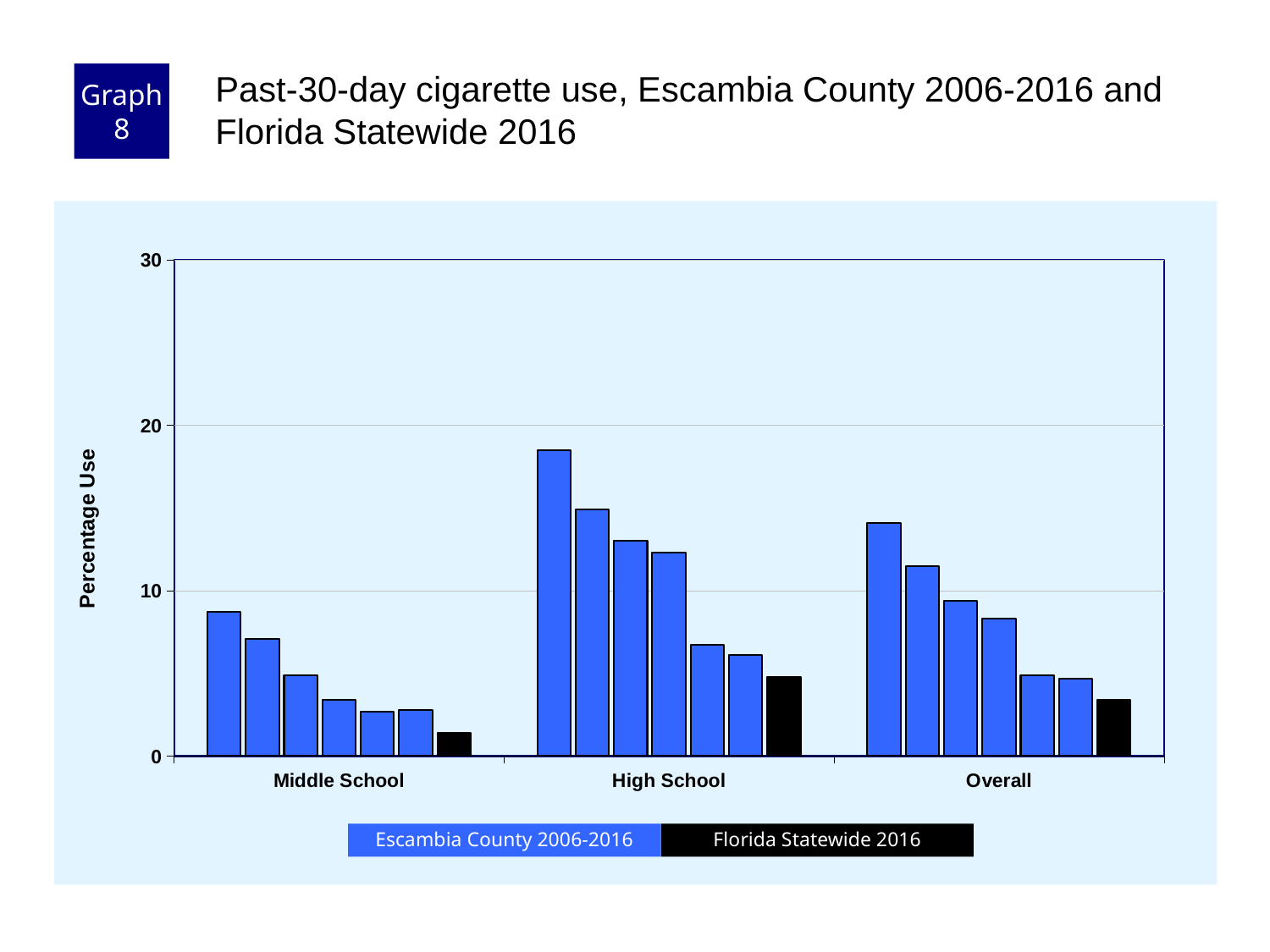
How many categories are shown along the x axis? 3 Which colour represents Florida Statewide 2016 in the legend? black Which category group contains the tallest bar on the chart? High School What is the label of the y axis? Percentage Use Is the value of the tallest Escambia County bar in the High School group greater or less than 10? greater How many series does the legend list? 2 Within the High School group, do the Escambia County 2006-2016 bars rise or fall from left to right? fall Which category group contains the shortest bar on the chart? Middle School Is the value of the tallest Escambia County bar in the Middle School group greater or less than 10? less Which is larger, the Florida Statewide 2016 bar for High School or the Florida Statewide 2016 bar for Middle School? High School What kind of chart is shown on the slide? bar chart Is the Florida Statewide 2016 value for High School greater or less than 10? less